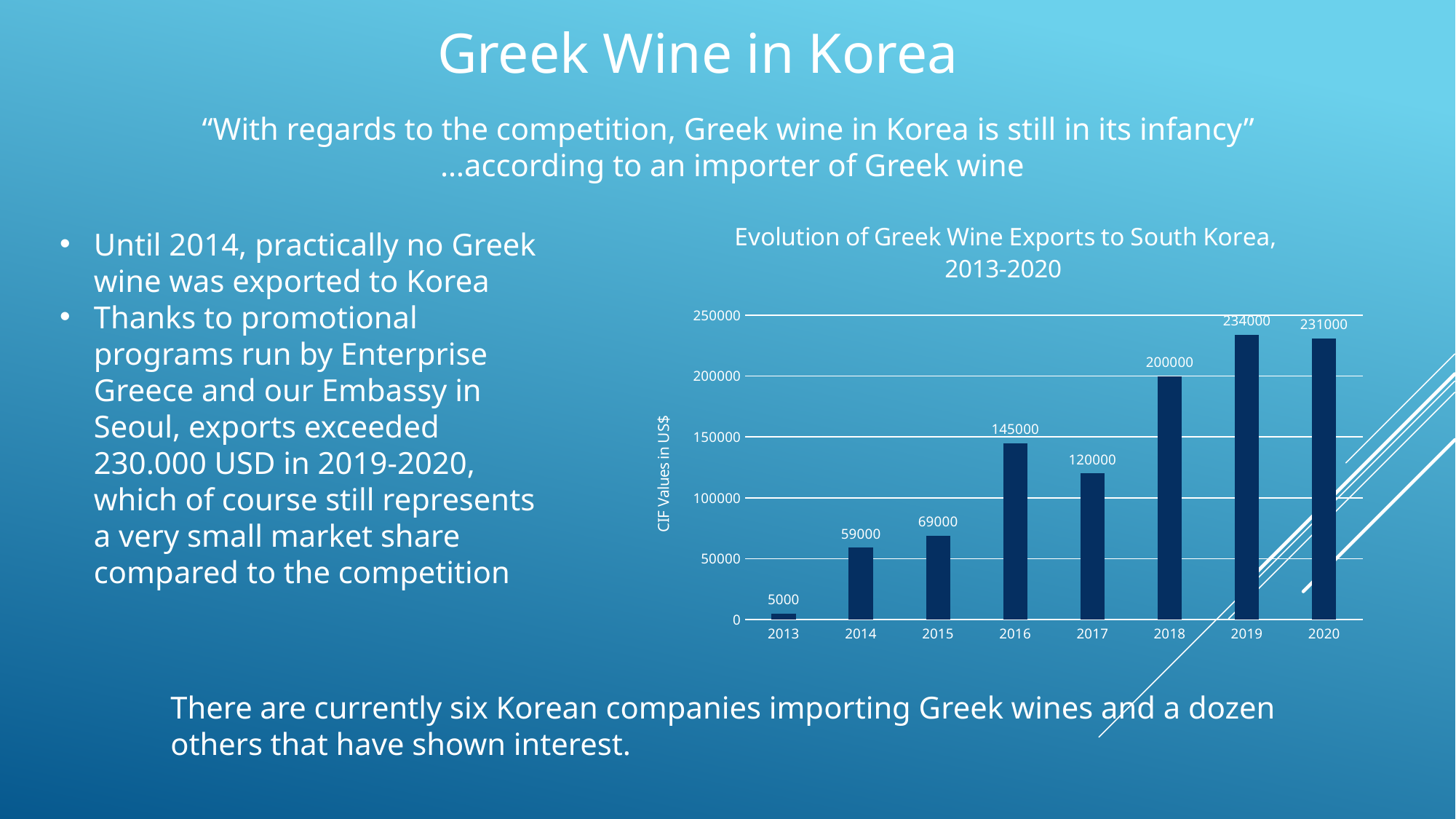
What is the value for 2020? 231000 Which year has the lowest value? 2013 What is the value for 2016? 145000 Which year has the highest value? 2019 What is the label of the vertical axis? CIF Values in US$ Is the value for 2015 greater or less than 100000? less What is the value for 2013? 5000 What is the difference between the values for 2019 and 2020? 3000 Which is larger, the value for 2016 or the value for 2017? 2016 What is the difference between the values for 2018 and 2017? 80000 How many years are shown on the x axis? 8 What kind of chart is shown? bar chart